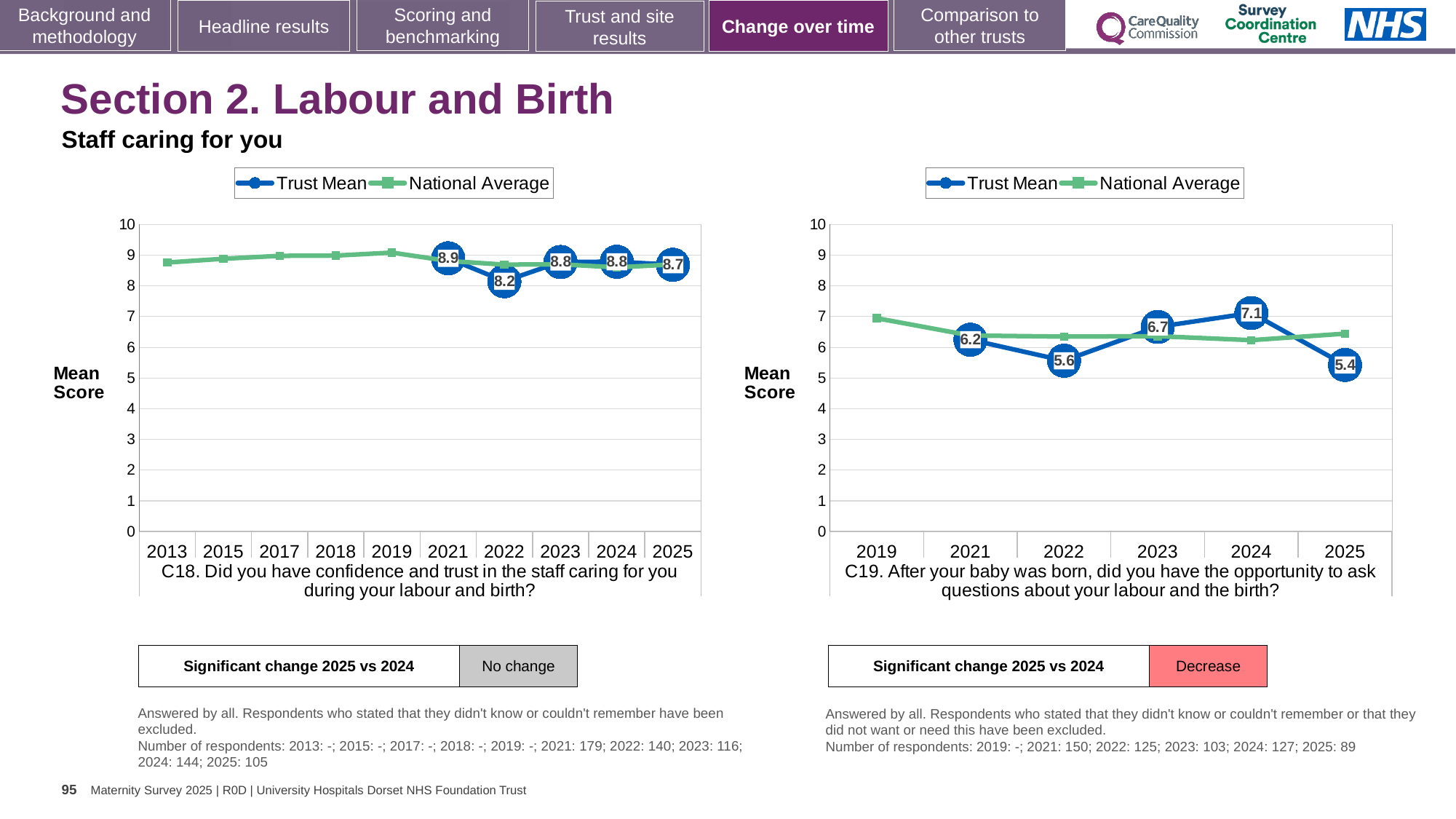
In the C18 chart, is the Trust Mean for 2021 or 2022 larger? 2021 In the C18 chart, which year has the lowest Trust Mean? 2022 What kind of chart is the C18 chart? Line chart In the C19 chart, what is the difference between the Trust Mean for 2024 and 2025? 1.7 In the C18 chart, what is the Trust Mean for 2025? 8.7 In the C19 chart, which year has the lowest Trust Mean? 2025 In the C19 chart, which year has the highest Trust Mean? 2024 In the C19 chart, is the National Average for 2019 greater or less than 6? greater In the C19 chart, what is the Trust Mean for 2025? 5.4 How many series does the legend of the C19 chart list? 2 In the C19 chart, what is the Trust Mean for 2024? 7.1 In the C18 chart, what is the Trust Mean for 2022? 8.2